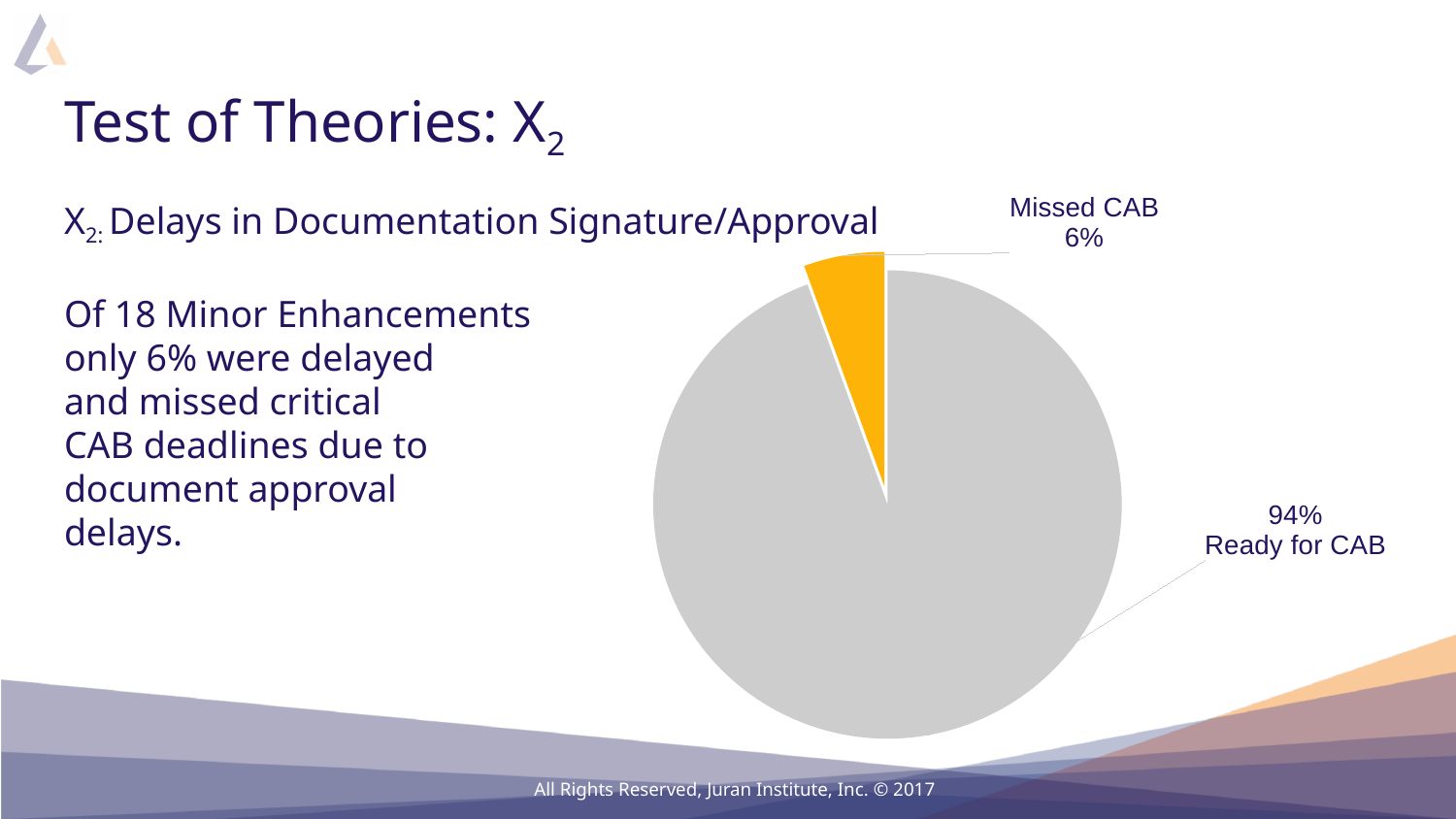
What do the two slice percentages add up to? 100% What colour is the Ready for CAB slice? grey Which slice of the pie is the smallest? Missed CAB What is the difference in percentage points between the Ready for CAB slice and the Missed CAB slice? 88 What share of the pie is labelled Ready for CAB? 94% Which is larger, the Missed CAB slice or the Ready for CAB slice? Ready for CAB How many slices does the pie chart have? 2 What colour is the Missed CAB slice? orange Which slice of the pie is the largest? Ready for CAB What share of the pie is labelled Missed CAB? 6% What kind of chart is shown on the slide? pie chart